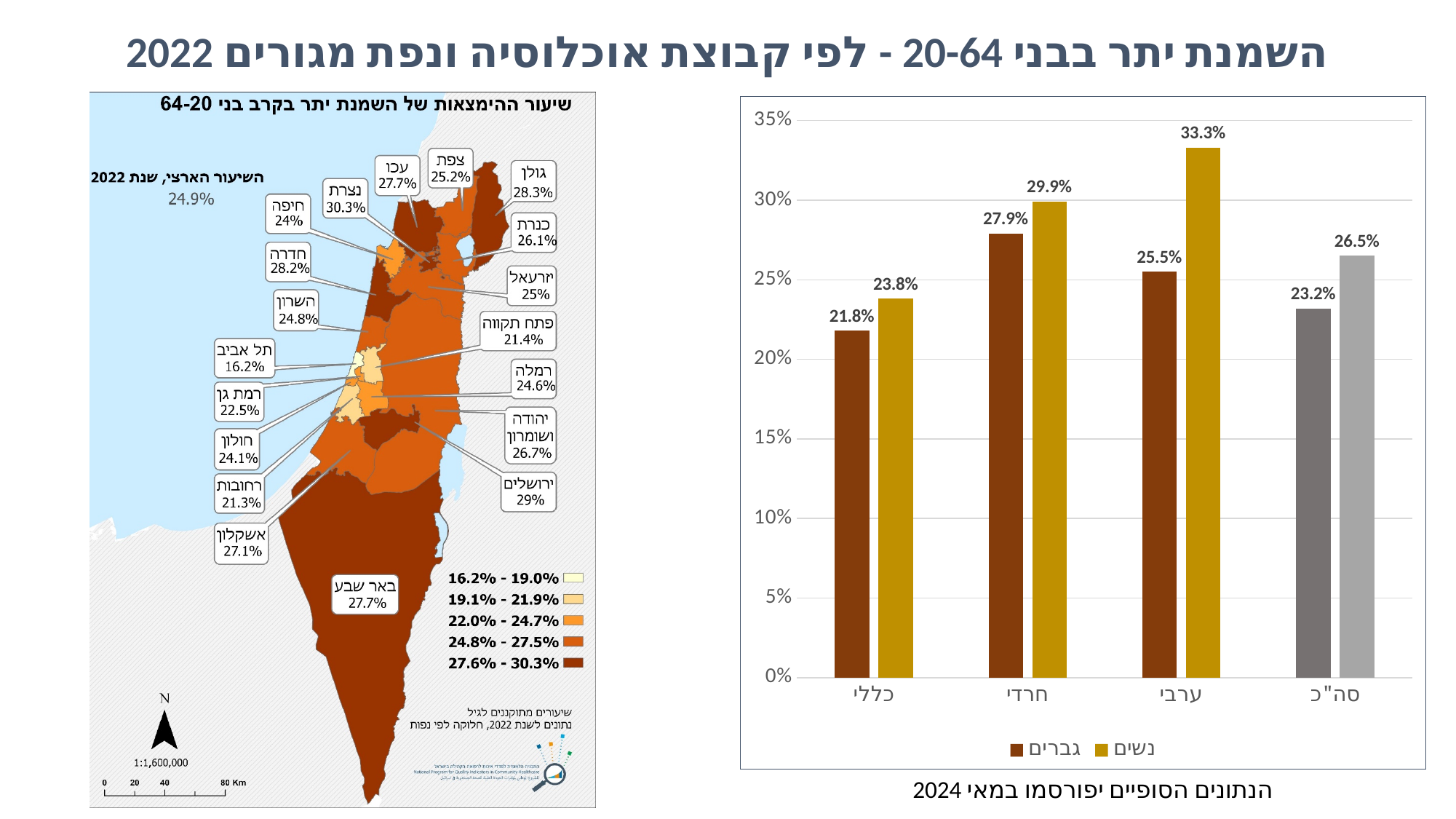
In the bar chart on the right, how many series does the legend list? 2 On the map on the left, what is the national rate (השיעור הארצי) for 2022? 24.9% In the bar chart on the right, how many categories are shown on the x axis? 4 What kind of chart is shown on the right side of the slide? bar chart In the bar chart on the right, what is the value for גברים in the כללי category? 21.8% In the bar chart on the right, what is the value for נשים in the ערבי category? 33.3% On the map on the left, what is the value shown for תל אביב? 16.2% In the bar chart on the right, which category has the highest value for נשים? ערבי In the bar chart on the right, which is larger in the חרדי category: גברים or נשים? נשים In the bar chart on the right, what is the value for גברים in the סה"כ category? 23.2% In the bar chart on the right, what is the difference between the נשים and גברים values in the ערבי category? 7.8% In the bar chart on the right, which category has the lowest value for גברים? כללי